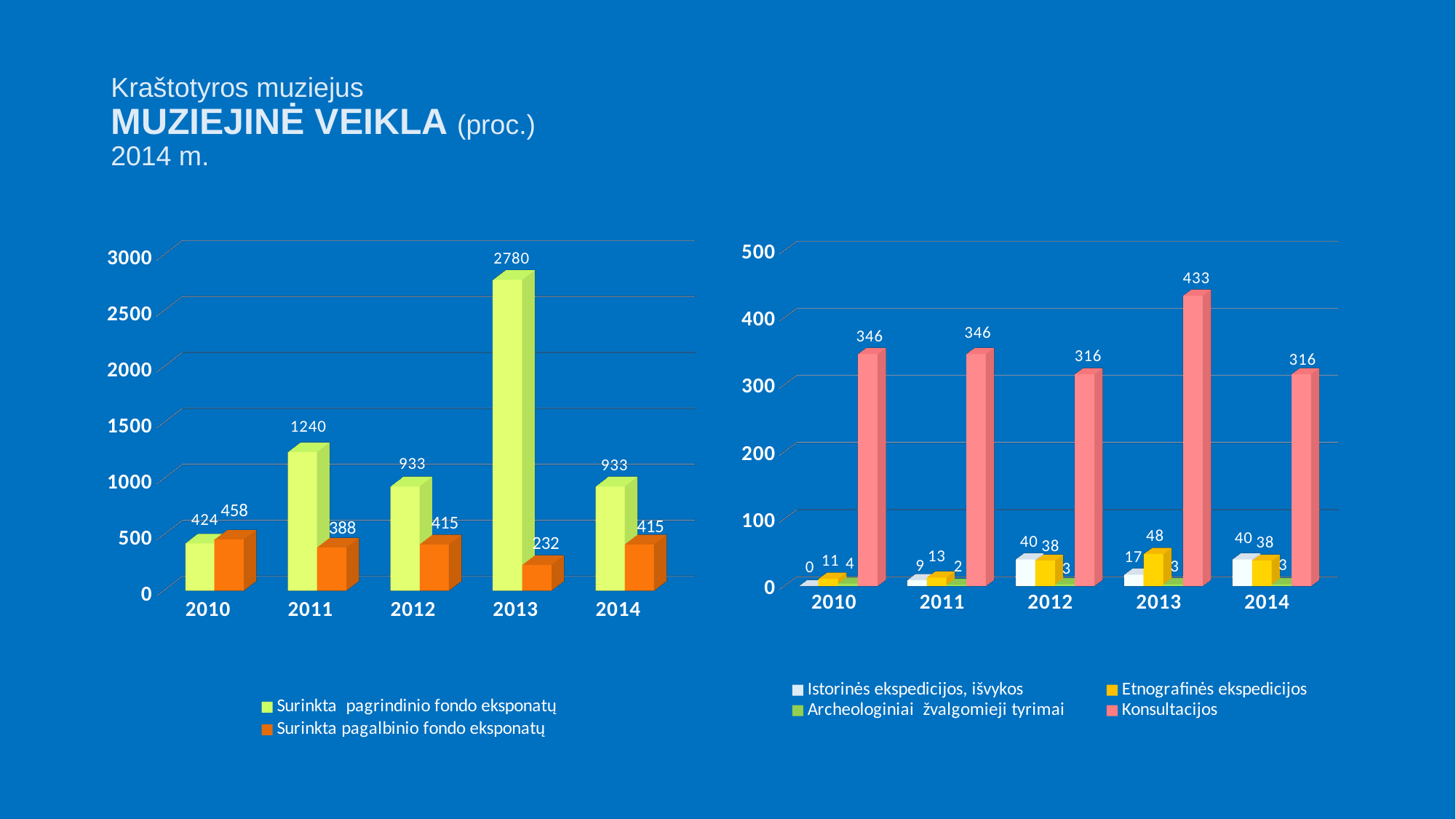
What kind of chart is the right chart? bar chart In the right chart, is the value of 'Istorinės ekspedicijos, išvykos' for 2012 larger or smaller than the value for 2013? larger In the left chart, what is the value of 'Surinkta pagrindinio fondo eksponatų' for 2013? 2780 In the left chart, what is the difference between 'Surinkta pagrindinio fondo eksponatų' in 2013 and in 2011? 1540 In the left chart, which year has the highest value for 'Surinkta pagrindinio fondo eksponatų'? 2013 In the left chart, what is the value of 'Surinkta pagalbinio fondo eksponatų' for 2011? 388 In the left chart, which year has the lowest value for 'Surinkta pagalbinio fondo eksponatų'? 2013 In the right chart, how many series does the legend list? 4 In the left chart, how many series does the legend list? 2 In the right chart, which year has the highest value for 'Konsultacijos'? 2013 In the right chart, what is the value of 'Etnografinės ekspedicijos' for 2013? 48 In the right chart, what is the value of 'Konsultacijos' for 2013? 433